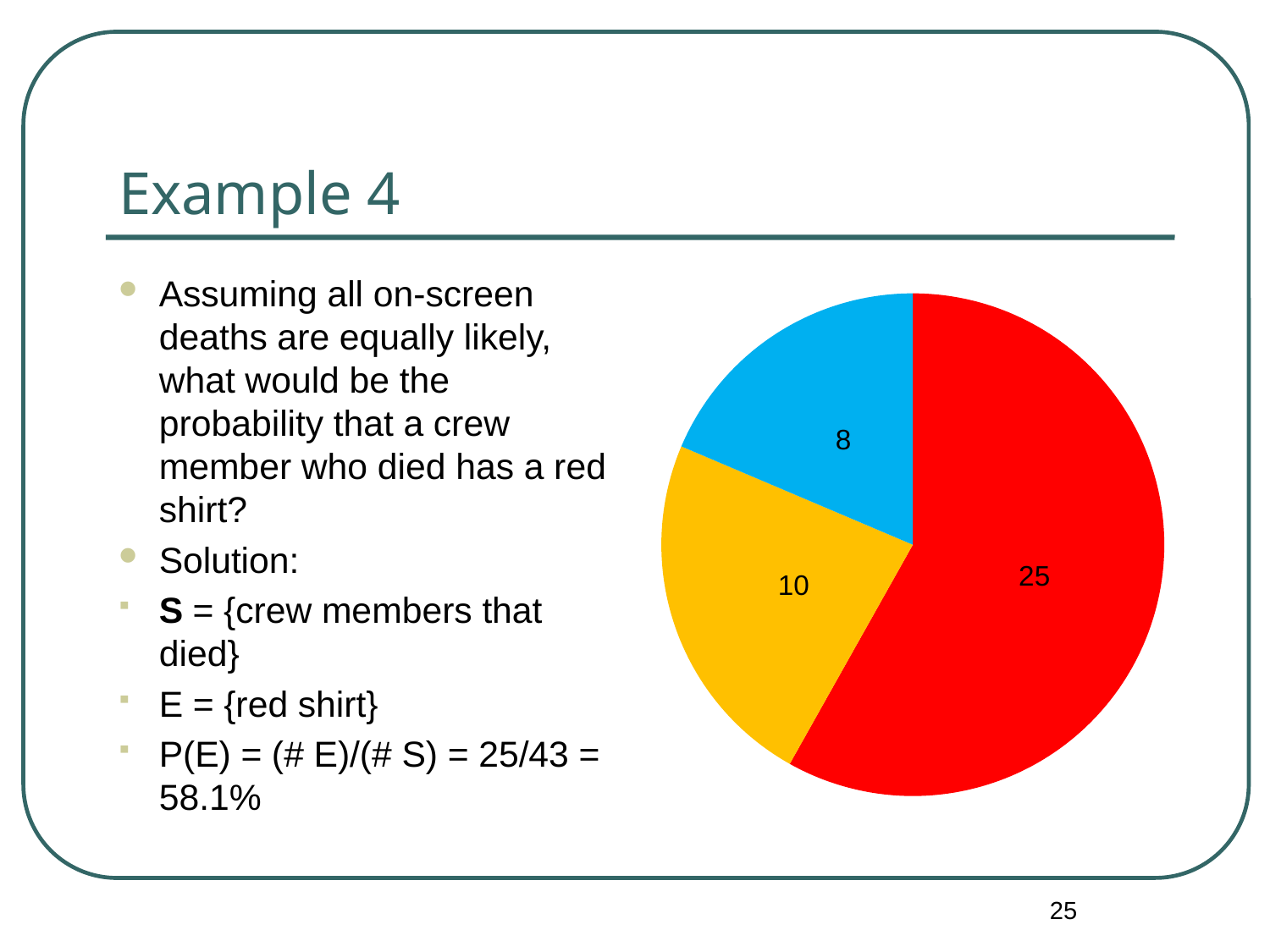
What is the value of the blue slice in the pie chart? 8 Which is larger in the pie chart, the yellow slice or the blue slice? the yellow slice What is the difference between the yellow slice and the blue slice in the pie chart? 2 How many slices does the pie chart have? 3 What is the value of the yellow slice in the pie chart? 10 Which slice of the pie chart has the largest value? the red slice (25) What type of chart is shown on the slide? pie chart What is the value of the red slice in the pie chart? 25 Which slice of the pie chart has the smallest value? the blue slice (8) What is the difference between the red slice and the yellow slice in the pie chart? 15 What is the total of all slices in the pie chart? 43 What share of the pie chart does the red slice represent? 58.1%